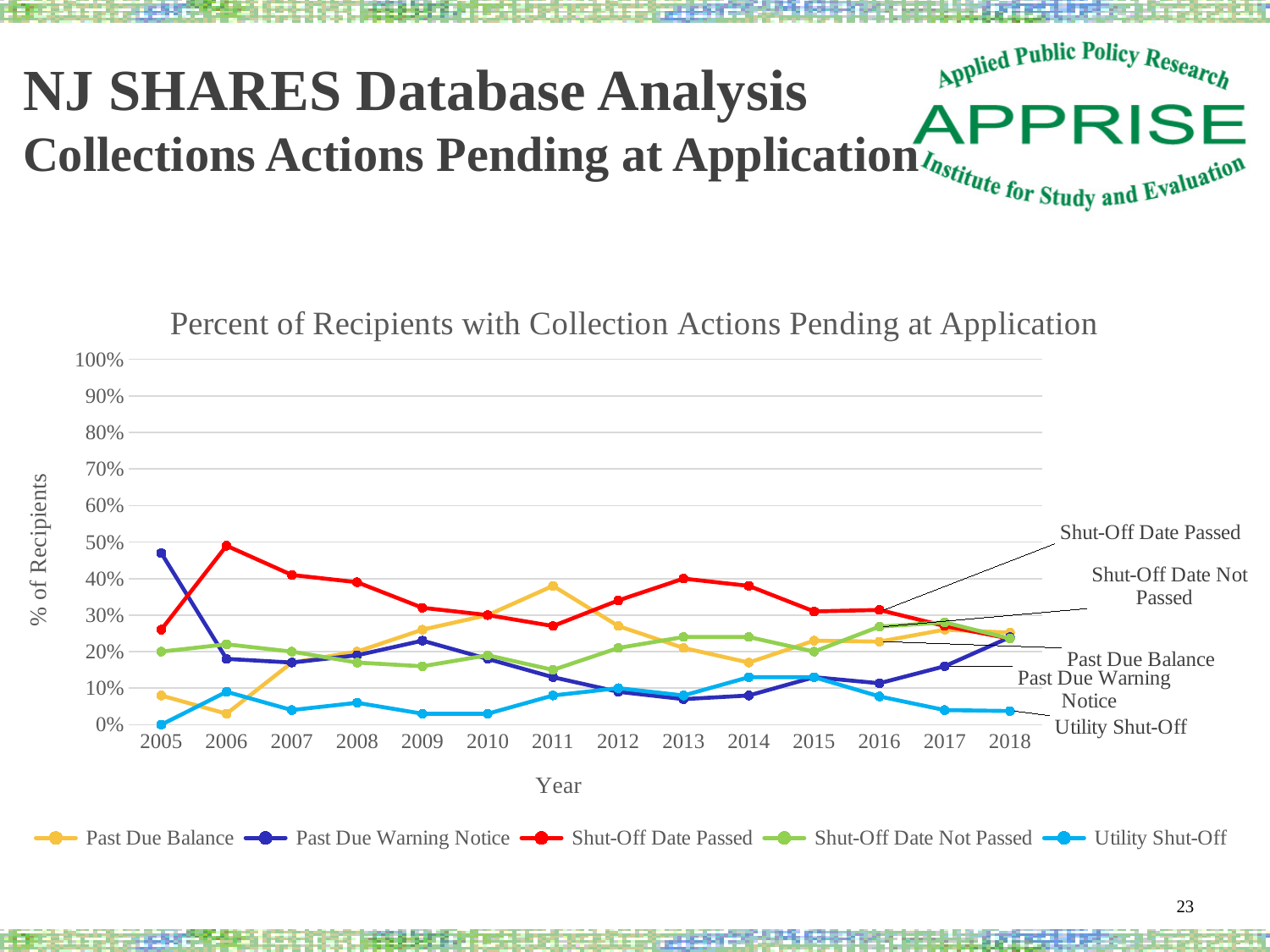
Is the value for Past Due Balance in 2011 greater or less than 30%? greater What is the title of the x axis? Year How many years are plotted along the x axis? 14 Does the Past Due Warning Notice line rise or fall from 2005 to 2006? Fall In which year is Past Due Balance at its lowest? 2006 In which year is Past Due Warning Notice at its highest? 2005 In 2013, which is larger: Shut-Off Date Passed or Past Due Balance? Shut-Off Date Passed Is the value for Utility Shut-Off in 2005 greater or less than 10%? less How many series does the legend list? 5 What kind of chart is shown on the slide? Line chart Is the value for Past Due Warning Notice in 2005 greater or less than 40%? greater Which series has the highest value in 2006? Shut-Off Date Passed